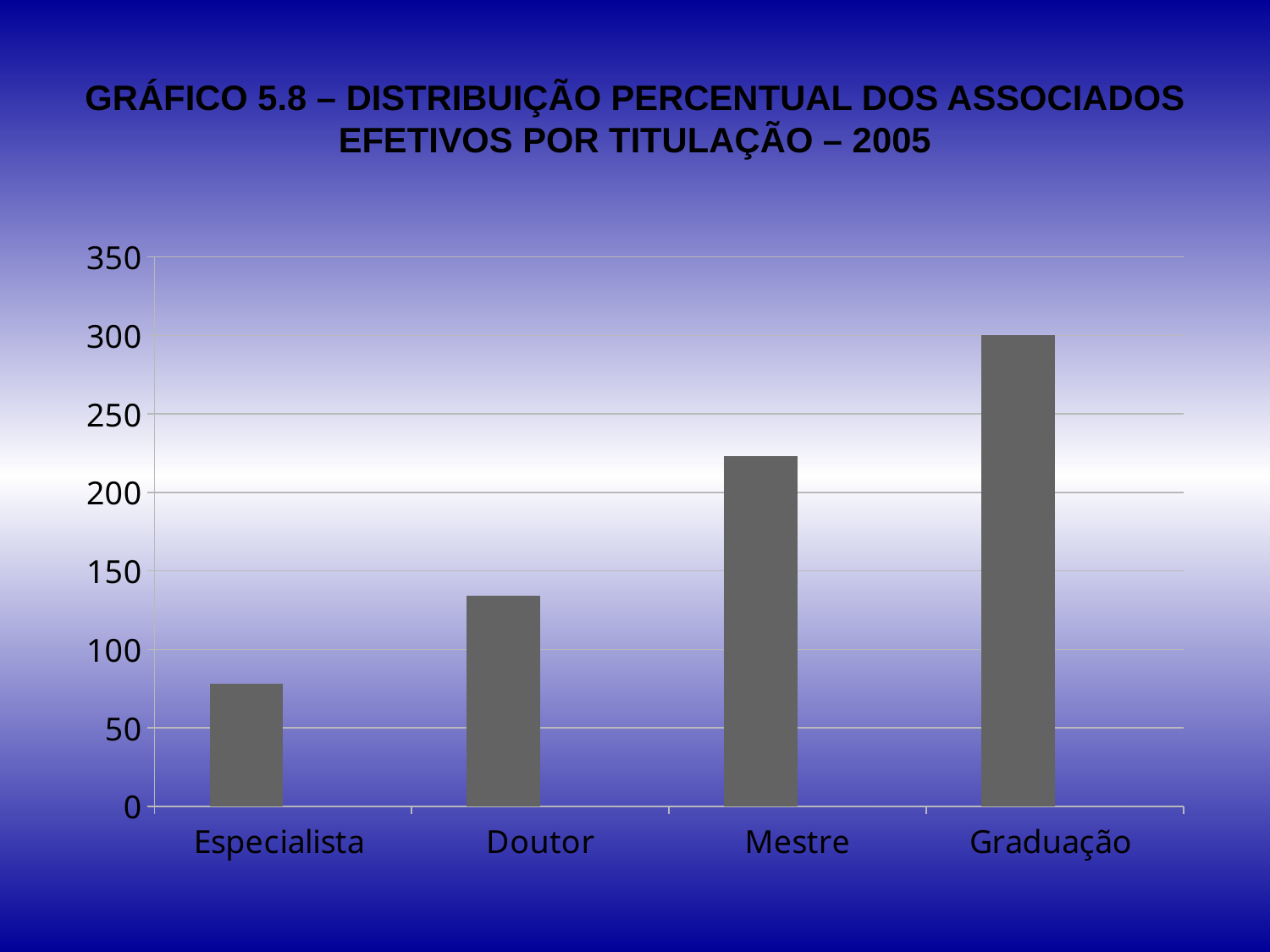
Is the value for Especialista greater or less than 100? less Is the value for Graduação greater or less than 250? greater What kind of chart is shown on the slide? bar chart Which category has the highest bar? Graduação Is the value for Mestre greater or less than 200? greater Which is larger, the value for Mestre or the value for Doutor? Mestre How many categories are shown on the x axis? 4 What year is given in the chart title? 2005 Which category has the lowest bar? Especialista Which is larger, the value for Especialista or the value for Doutor? Doutor Do the bar values rise or fall from left to right along the x axis? rise